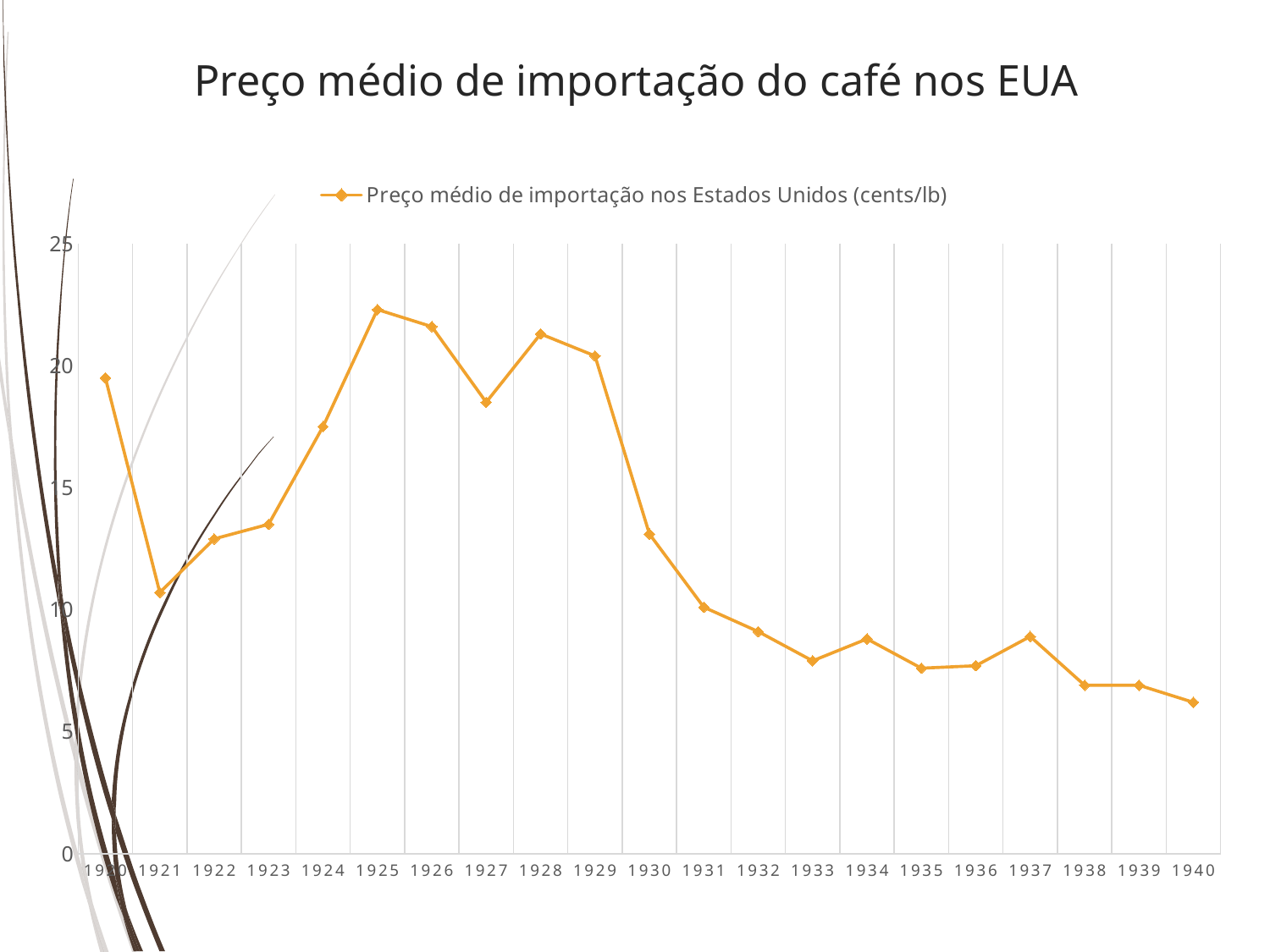
How many series does the legend list? 1 In which year is the average import price highest? 1925 What is the title of the chart? Preço médio de importação do café nos EUA What kind of chart is shown on the slide? line chart Is the value for 1930 greater or less than 15? less Is the value for 1925 greater or less than 20? greater What is the legend entry for the plotted series? Preço médio de importação nos Estados Unidos (cents/lb) Which year has the higher value, 1920 or 1921? 1920 In which year is the average import price lowest? 1940 How many years are plotted along the x axis? 21 Is the value for 1940 greater or less than 10? less Does the average import price rise or fall from 1929 to 1933? fall